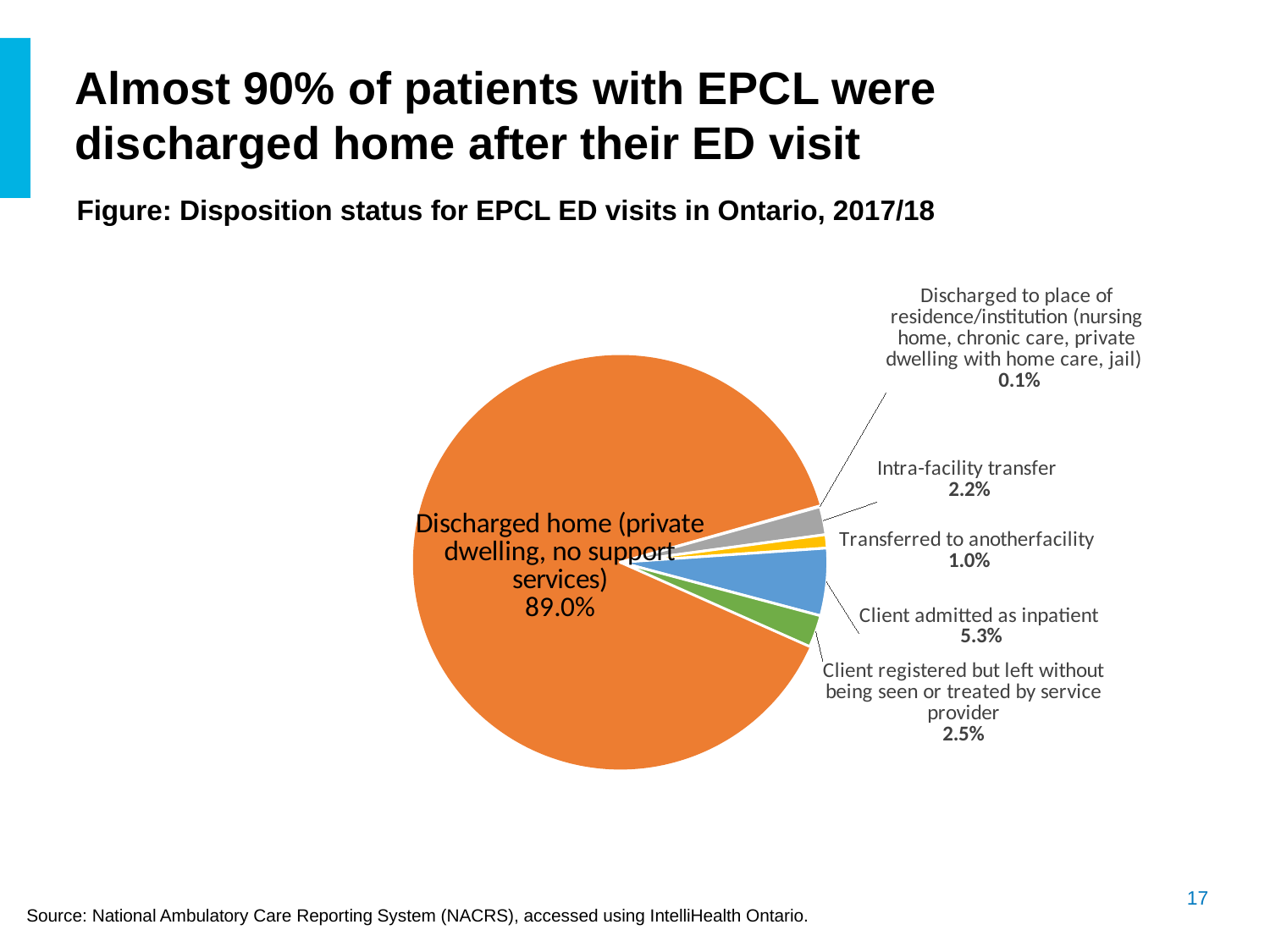
Which disposition status has the largest share of the pie? Discharged home (private dwelling, no support services) What percentage of visits were discharged to place of residence/institution (nursing home, chronic care, private dwelling with home care, jail)? 0.1% What is the difference in percentage points between clients admitted as inpatient and clients who registered but left without being seen? 2.8 percentage points What type of chart is shown on the slide? Pie chart What percentage of visits resulted in the client being admitted as inpatient? 5.3% What percentage of clients registered but left without being seen or treated by a service provider? 2.5% How many disposition categories are shown in the pie chart? 6 Which is larger: the share for intra-facility transfer or the share transferred to another facility? Intra-facility transfer What share of EPCL ED visits were discharged home (private dwelling, no support services)? 89.0% Which disposition status has the smallest share of the pie? Discharged to place of residence/institution (nursing home, chronic care, private dwelling with home care, jail) What percentage of visits were intra-facility transfers? 2.2% What percentage of visits were transferred to another facility? 1.0%